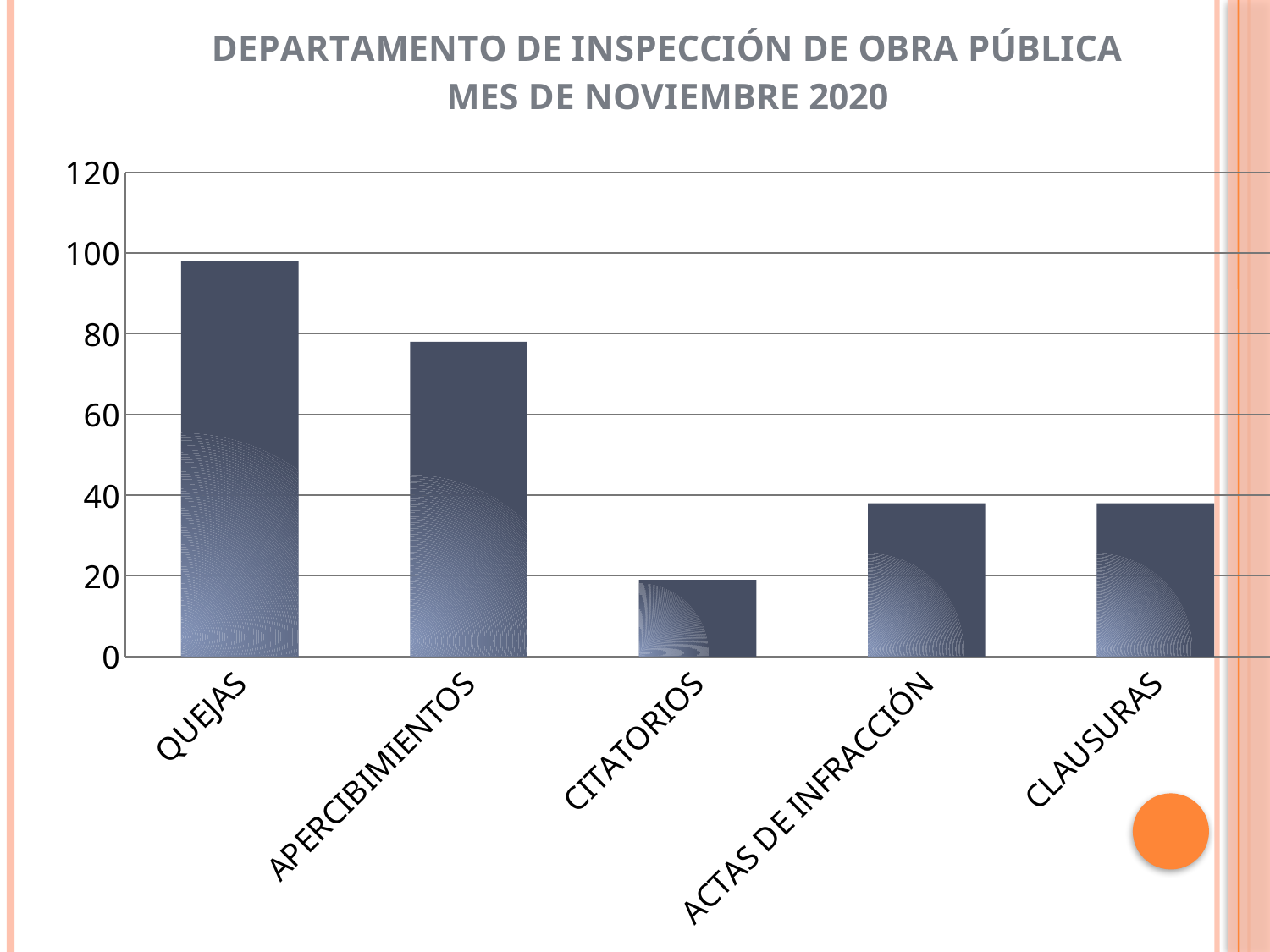
Is the value for CITATORIOS greater or less than 40? less Is the value for QUEJAS greater or less than 80? greater Is the value for QUEJAS greater or less than 100? less Which category has the lowest value in the chart? CITATORIOS What kind of chart is shown on the slide? bar chart Which is larger, the value for QUEJAS or the value for APERCIBIMIENTOS? QUEJAS What month and year does the chart title refer to? NOVIEMBRE 2020 Which is larger, the value for CITATORIOS or the value for ACTAS DE INFRACCIÓN? ACTAS DE INFRACCIÓN Which category has the highest value in the chart? QUEJAS How many categories are shown on the x axis of the chart? 5